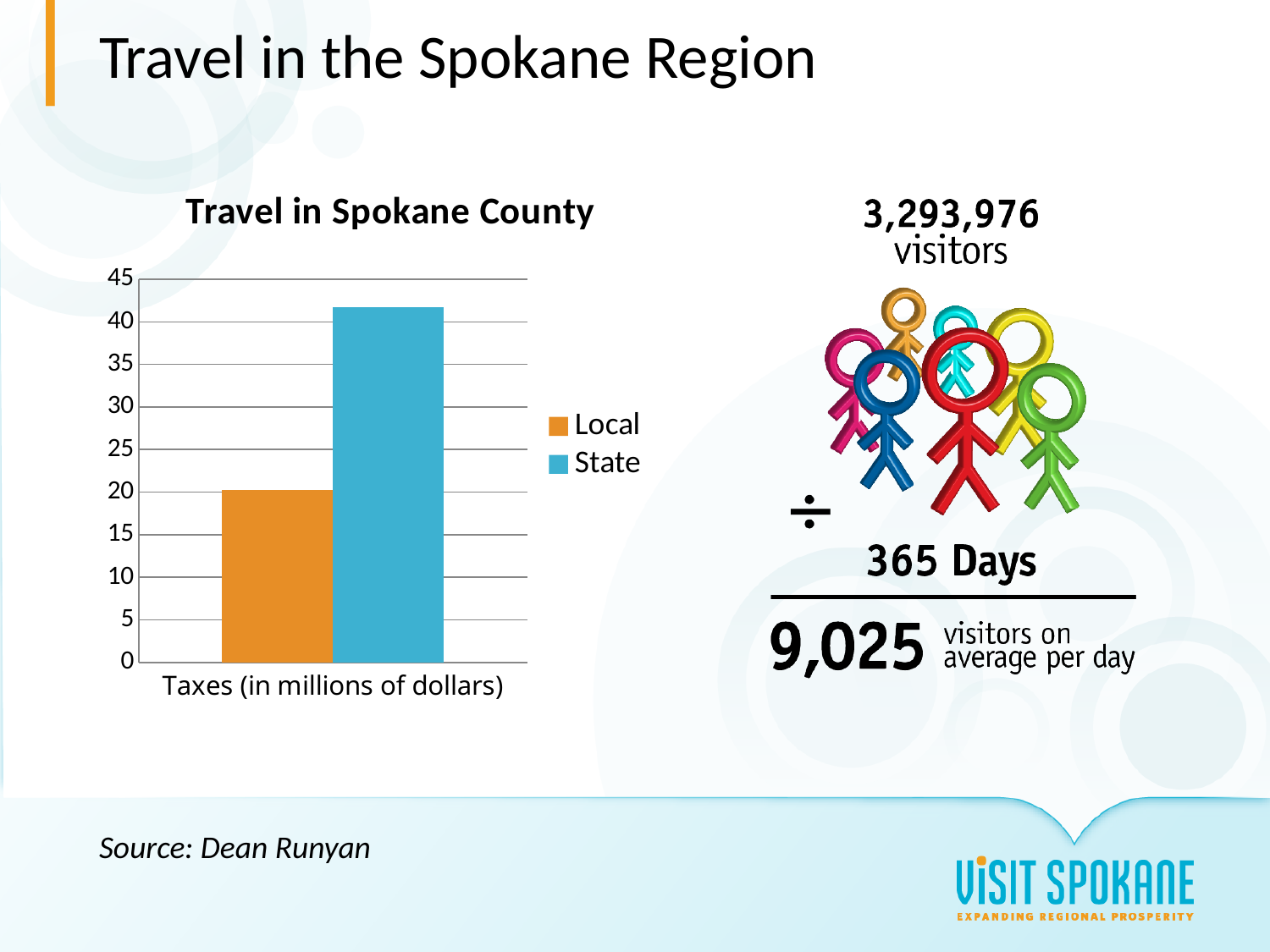
In the "Travel in Spokane County" chart, is the value for State greater or less than 45? less In the "Travel in Spokane County" chart, which series has the shorter bar? Local What kind of chart is shown under the title "Travel in Spokane County"? bar chart How many categories are plotted on the x axis of the "Travel in Spokane County" chart? 1 In the "Travel in Spokane County" chart, which series has the taller bar, Local or State? State In the "Travel in Spokane County" chart, is the value for State greater or less than 40? greater In the "Travel in Spokane County" chart, is the value for Local greater or less than 25? less In the "Travel in Spokane County" chart, which colour represents the Local series? orange How many series does the legend of the "Travel in Spokane County" chart list? 2 What is the x-axis label of the "Travel in Spokane County" chart? Taxes (in millions of dollars) In the "Travel in Spokane County" chart, is the Local bar larger or smaller than the State bar? smaller